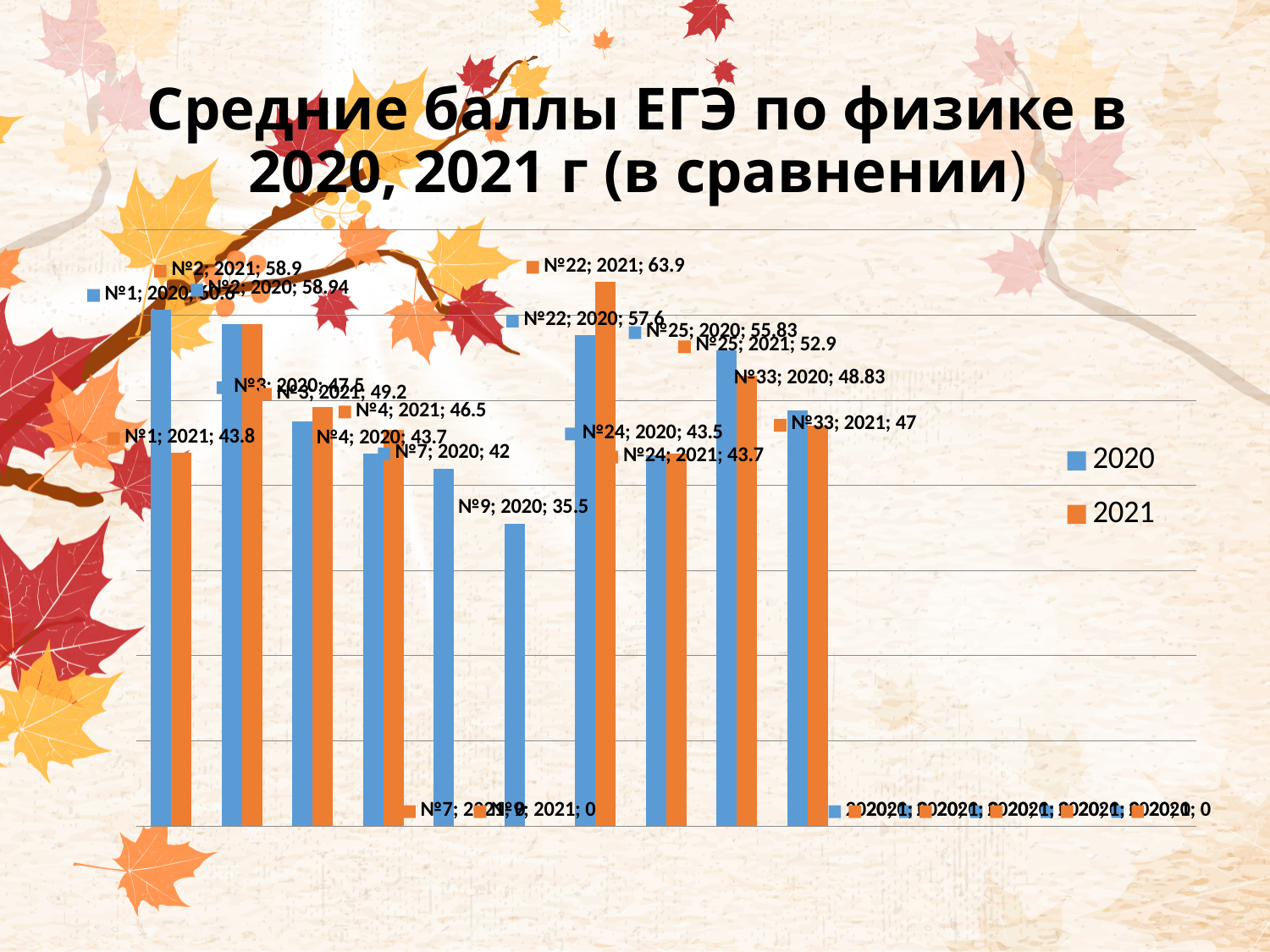
Which category has the highest 2021 value? №22 What is the 2020 value for №9? 35.5 What kind of chart is shown on the slide? Bar chart What is the difference between the 2020 and 2021 values for №25? 2.93 What is the 2021 value for №33? 47 What is the 2021 value for №1? 43.8 What is the 2021 value for №22? 63.9 What is the 2020 value for №25? 55.83 What is the difference between the 2021 and 2020 values for №22? 6.3 How many series does the legend list? 2 For №4, which year has the larger value, 2020 or 2021? 2021 Which has the larger 2021 value, №3 or №4? №3